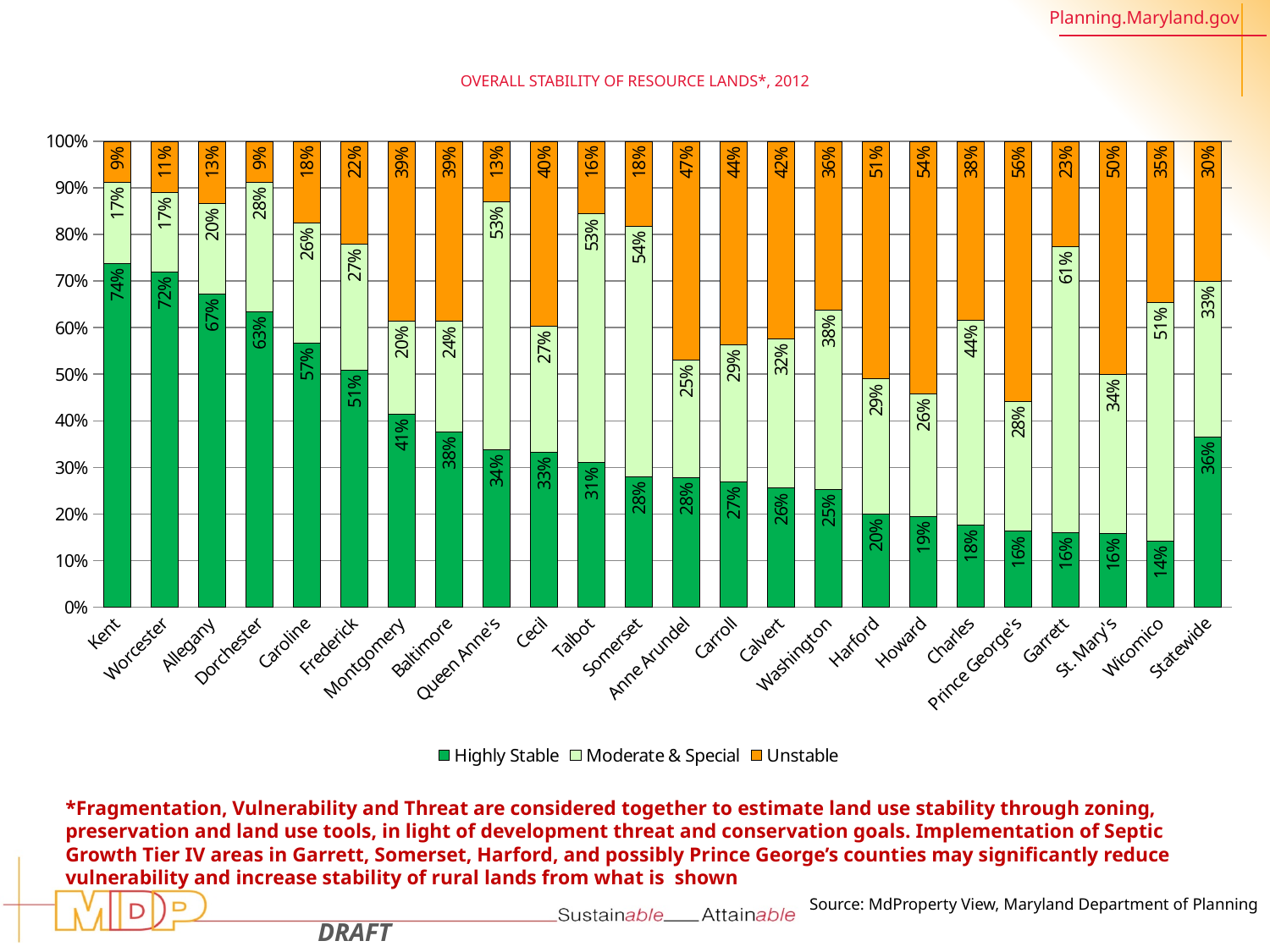
Which county has the lowest Highly Stable percentage? Wicomico What is the difference between the Highly Stable percentages of Kent and Worcester? 2% Which county has the highest Unstable percentage? Prince George's What is the Moderate & Special percentage for Garrett? 61% Which has a larger Unstable percentage, Howard or Harford? Howard What is the Statewide Highly Stable percentage? 36% What kind of chart is shown on the slide? Stacked bar chart What is the Unstable percentage for Prince George's? 56% How many series does the legend list? 3 What is the Highly Stable percentage for Kent? 74% How many categories are shown on the x axis? 24 Which county has the highest Highly Stable percentage? Kent